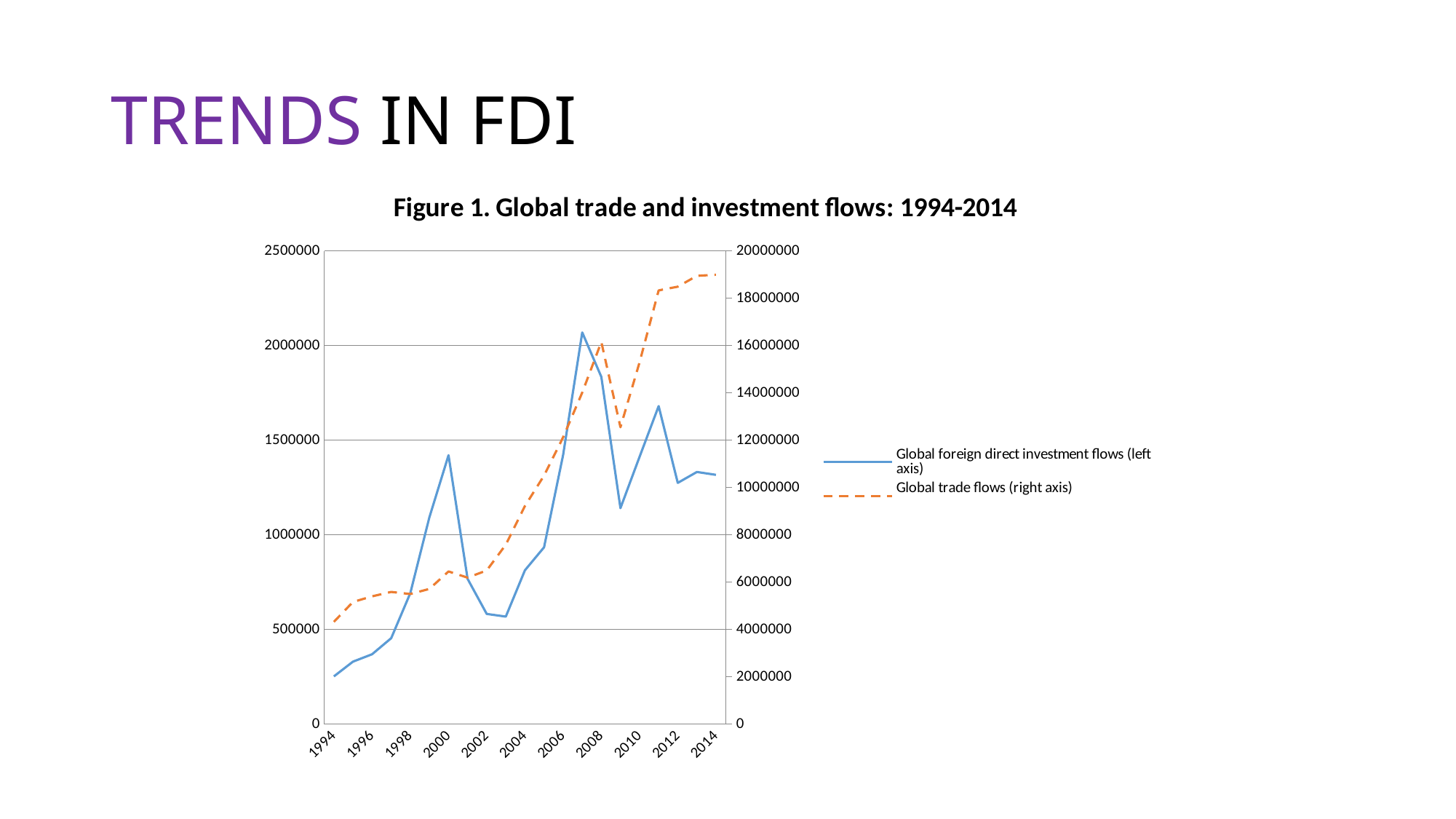
Which series in Figure 1 is drawn with a dashed line? Global trade flows (right axis) How many series does the legend of Figure 1 list? 2 Is the value of global trade flows in 2014 greater or less than 18000000? greater What kind of chart is shown in Figure 1? line chart Is the value of global foreign direct investment flows in 2000 greater or less than 1000000? greater Is the value of global trade flows in 1994 greater or less than 6000000? less In which year are global foreign direct investment flows at their lowest in Figure 1? 1994 In which year do global trade flows reach their highest value in Figure 1? 2014 What is the title of the chart on the slide? Figure 1. Global trade and investment flows: 1994-2014 Do global foreign direct investment flows rise or fall between 2007 and 2009? fall In which year do global foreign direct investment flows reach their highest value in Figure 1? 2007